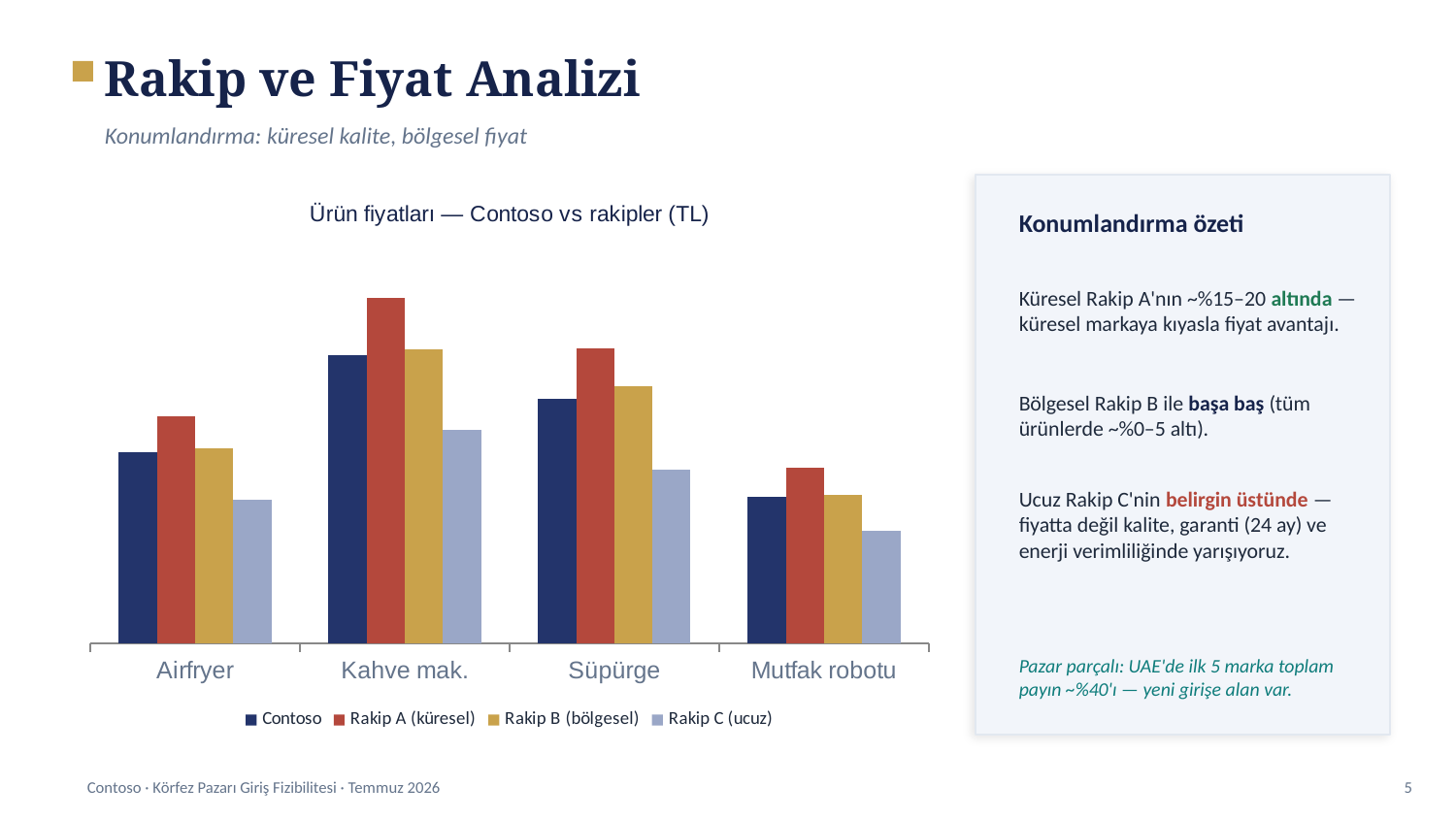
How many series does the chart legend list? 4 Which series has the lowest price in every product category? Rakip C (ucuz) Which series has the lowest price for Süpürge? Rakip C (ucuz) What kind of chart is shown on the slide? bar chart For which product category is the Contoso price lowest? Mutfak robotu How many product categories are shown on the x axis of the chart? 4 Which series has the highest price for Kahve mak.? Rakip A (küresel) For Airfryer, which is higher: the Contoso price or the Rakip A (küresel) price? Rakip A (küresel) Which series is listed last in the chart legend? Rakip C (ucuz) What is the title of the chart? Ürün fiyatları — Contoso vs rakipler (TL) For which product category is the Contoso price highest? Kahve mak. For Mutfak robotu, which is higher: the Rakip B (bölgesel) price or the Rakip C (ucuz) price? Rakip B (bölgesel)